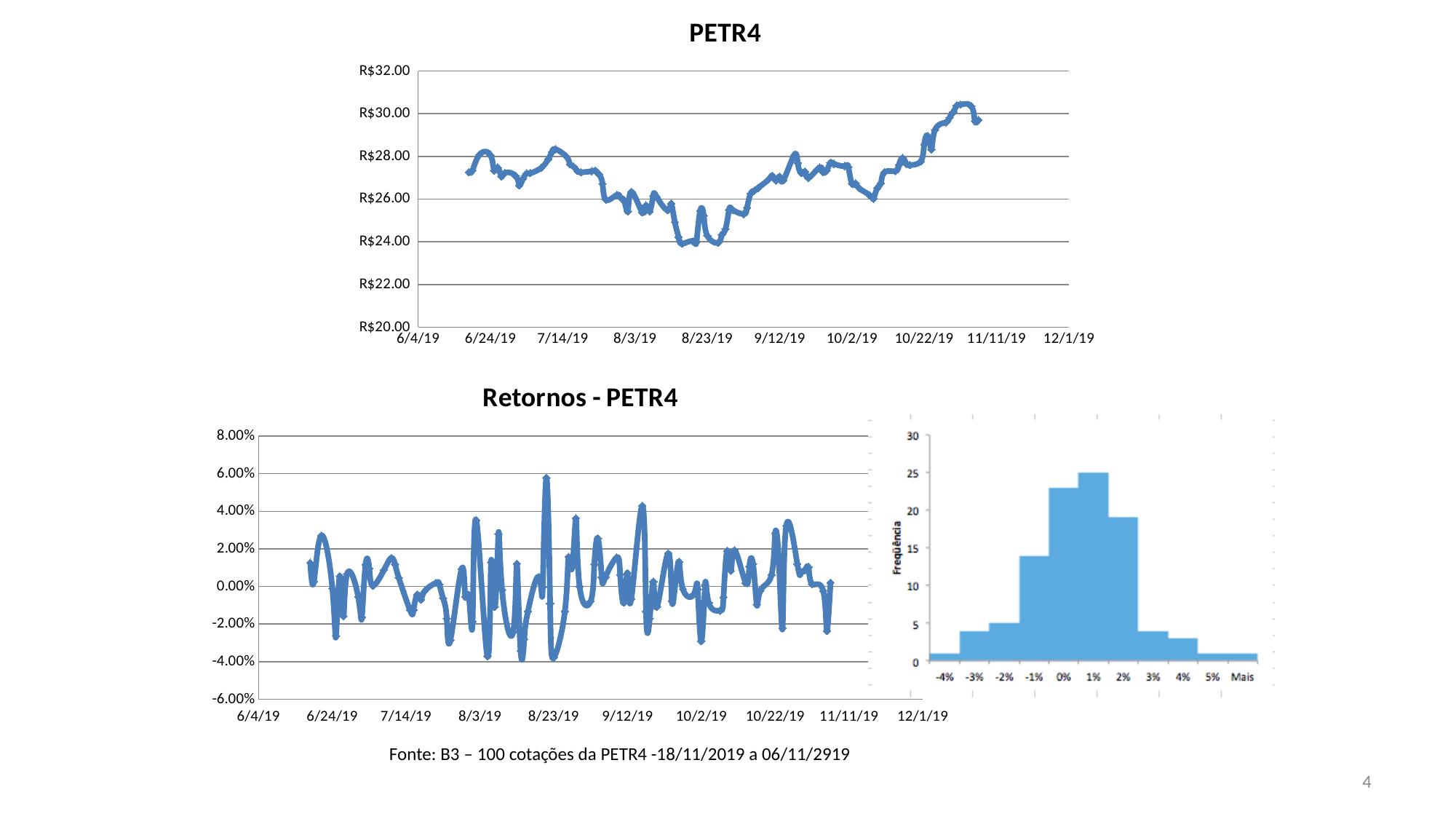
In the bottom-right histogram, what is the frequency of the 1% bin? 25 In the top PETR4 chart, is the price at the end of the series higher or lower than at the start? higher What kind of chart is the bottom-right chart with the Freqüência axis? bar chart In the bottom-right histogram, which bin has the highest frequency? 1% In the Retornos - PETR4 chart, is the lowest return greater or less than -2.00%? less In the bottom-right histogram, which bin has the higher frequency, 0% or 2%? 0% In the bottom-right histogram, is the frequency of the 0% bin greater or less than 20? greater What kind of chart is the top chart titled PETR4? line chart How many charts are shown on the slide? 3 In the Retornos - PETR4 chart, is the highest return greater or less than 4.00%? greater